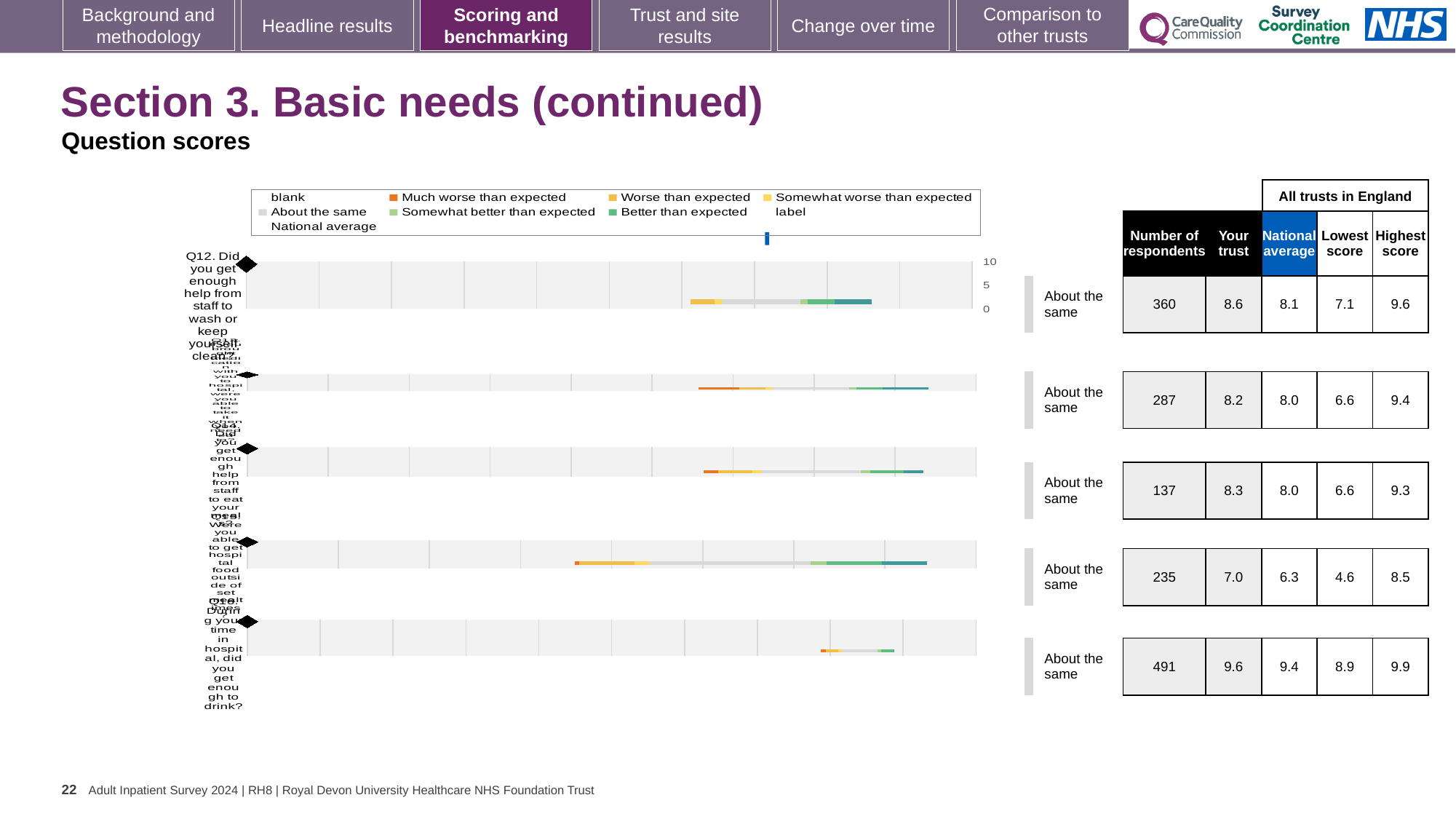
In the table next to the chart, what is the 'Your trust' score for the first row (Q12)? 8.6 What benchmark category is shown for every question row on the slide? About the same In the table next to the chart, what is the national average for the second row? 8.0 How many question rows are plotted in the chart? 5 In the table next to the chart, what is the highest score for the bottom row? 9.9 For the fourth row, which is larger: the 'Your trust' score or the national average? Your trust (7.0) What is the difference between the 'Your trust' score and the national average for the first row (Q12)? 0.5 Which row has the highest 'Your trust' score in the table next to the chart? the bottom (fifth) row, 9.6 What kind of chart is shown on the slide? bar chart In the table next to the chart, what is the lowest score for the fourth row? 4.6 In the table next to the chart, what is the number of respondents for the first row (Q12)? 360 Which row has the lowest 'Your trust' score in the table next to the chart? the fourth row, 7.0